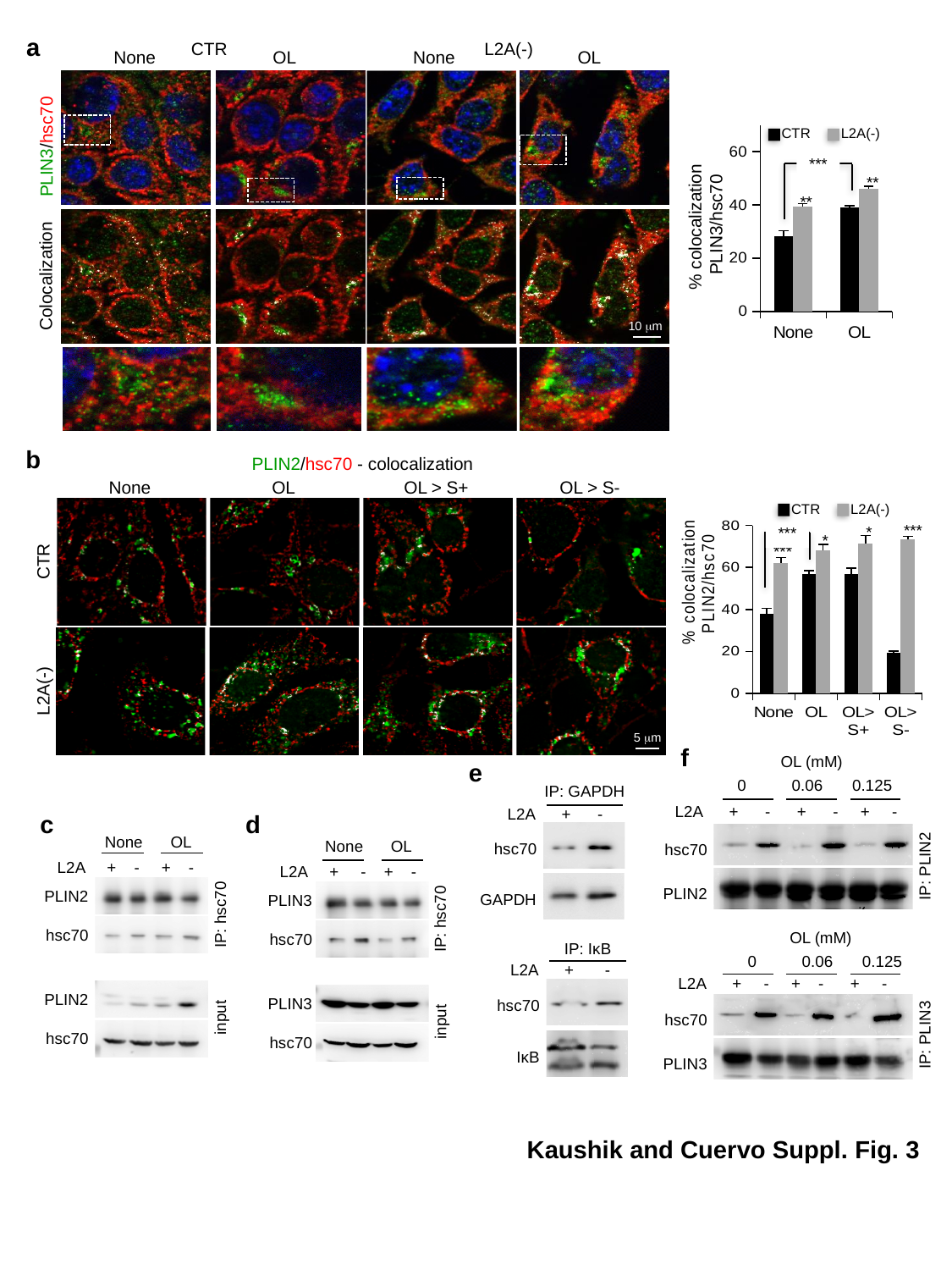
What kind of chart is the chart in panel a (% colocalization PLIN3/hsc70)? bar chart In the panel b chart (% colocalization PLIN2/hsc70), how many categories are shown on the x axis? 4 In the panel a chart (% colocalization PLIN3/hsc70), for the None condition, which is larger: CTR or L2A(-)? L2A(-) In the panel a chart (% colocalization PLIN3/hsc70), how many series does the legend list? 2 In the panel b chart, what colour are the CTR bars? black In the panel b chart (% colocalization PLIN2/hsc70), is the L2A(-) value for OL > S- greater or less than 60? greater In the panel b chart (% colocalization PLIN2/hsc70), is the CTR value for None greater or less than 20? greater In the panel a chart (% colocalization PLIN3/hsc70), is the CTR value for None greater or less than 40? less In the panel b chart (% colocalization PLIN2/hsc70), which category has the lowest CTR value? OL > S- In the panel a chart (% colocalization PLIN3/hsc70), which bar is the highest overall? L2A(-) for OL In the panel b chart (% colocalization PLIN2/hsc70), for OL > S-, which is larger: CTR or L2A(-)? L2A(-)